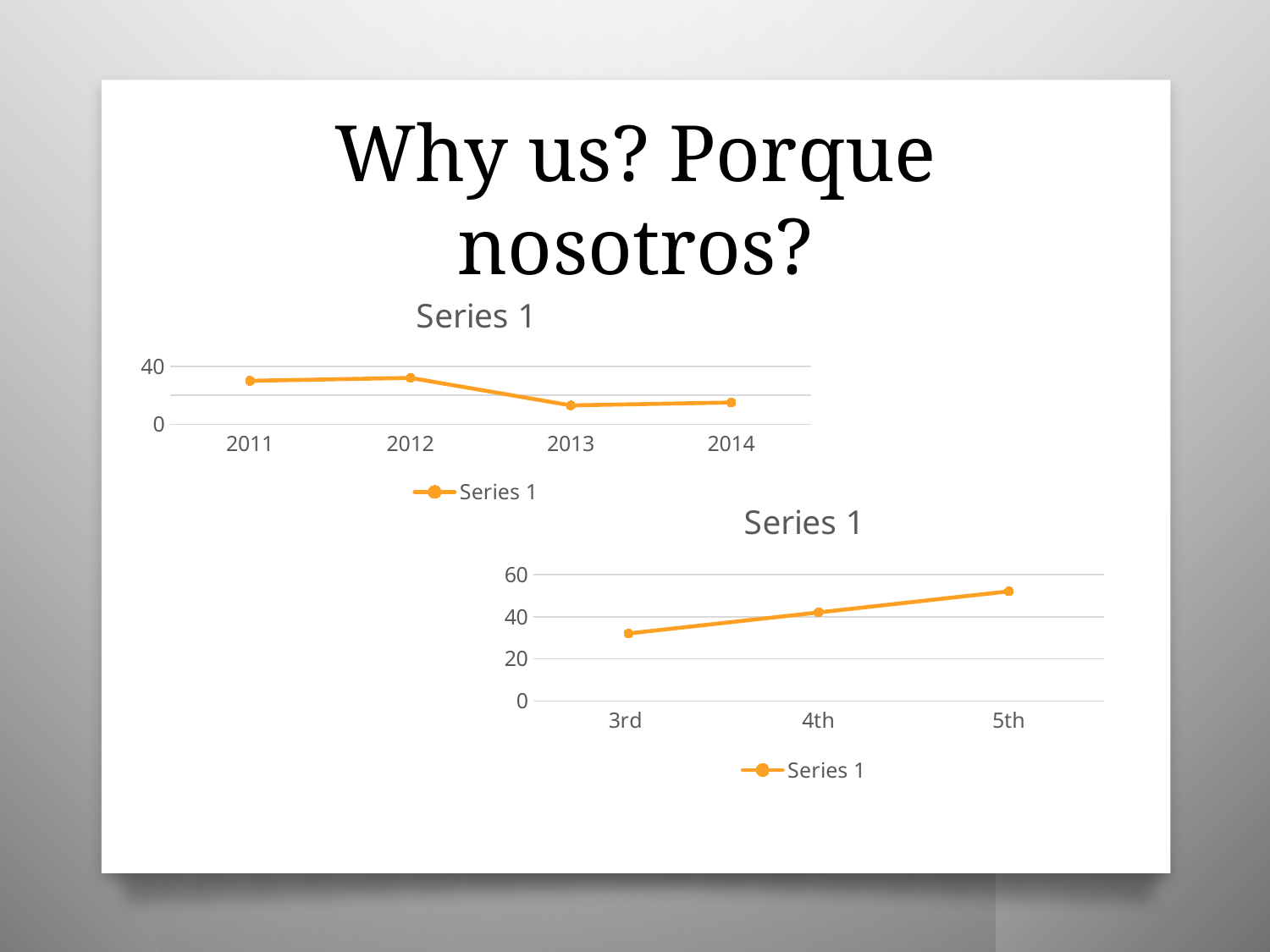
In the lower-right chart, which category has the highest value? 5th In the upper-left chart, is the value for 2013 greater or less than 20? less In the lower-right chart, is the value for 3rd greater or less than 40? less What kind of chart is the lower-right chart with categories 3rd, 4th and 5th? line chart How many series does the legend of the upper-left chart list? 1 In the lower-right chart, which category has the lowest value? 3rd What kind of chart is the upper-left chart with years 2011 to 2014? line chart In the upper-left chart, do the values generally rise or fall from 2011 to 2014? fall In the lower-right chart, do the values rise or fall from 3rd to 5th? rise In the upper-left chart (2011–2014), how many data points are plotted? 4 In the upper-left chart, is the value for 2011 greater or less than 20? greater In the lower-right chart (3rd, 4th, 5th), how many data points are plotted? 3